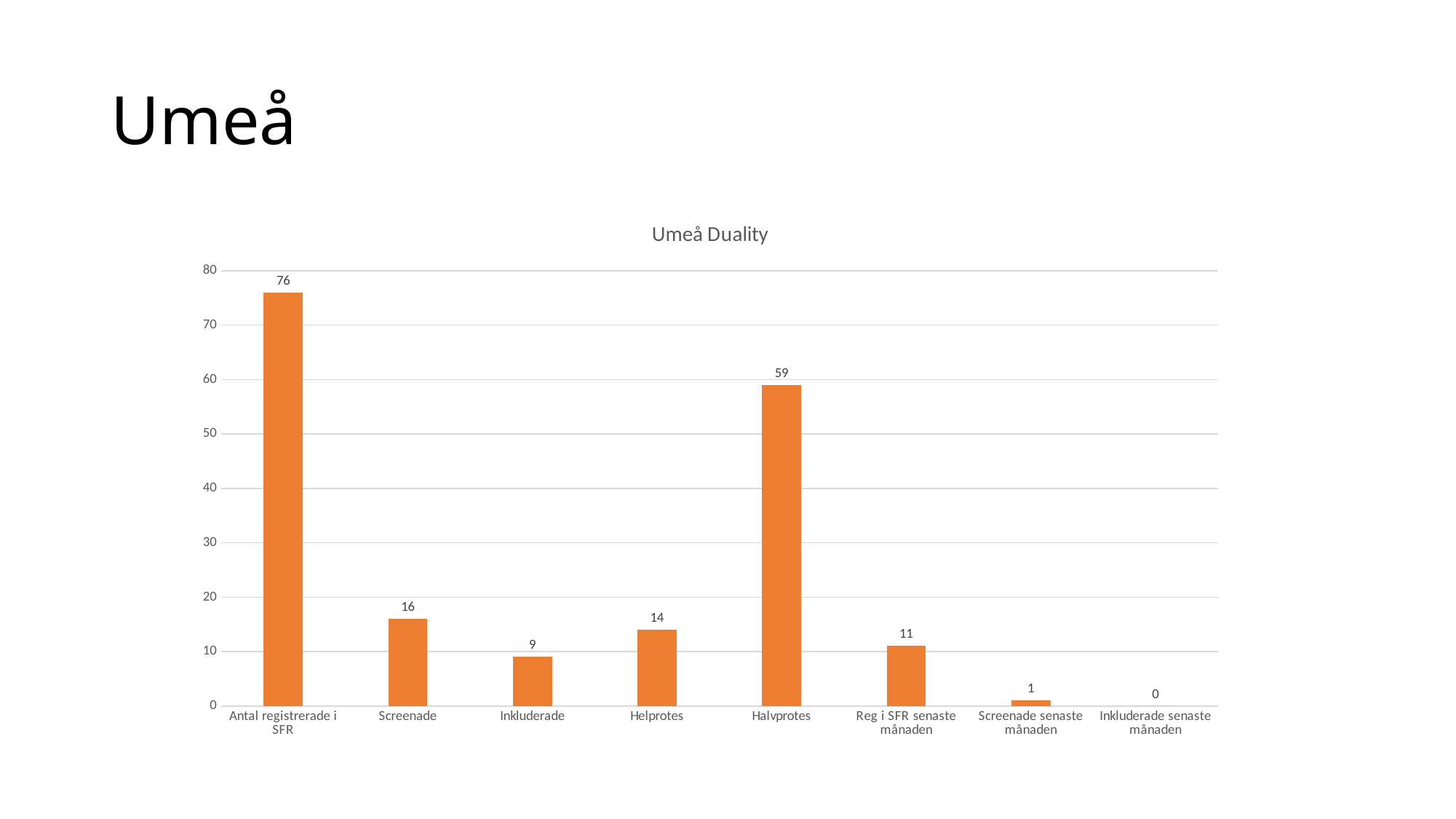
How many categories are shown on the x axis? 8 What is the title of the chart? Umeå Duality What is the value for Screenade senaste månaden? 1 What is the value for Inkluderade? 9 Which category has the highest value? Antal registrerade i SFR What is the difference between Antal registrerade i SFR and Halvprotes? 17 Which category has the lowest value? Inkluderade senaste månaden What kind of chart is this? Bar chart What is the difference between Screenade and Helprotes? 2 What is the value for Antal registrerade i SFR? 76 Which is larger, Screenade or Reg i SFR senaste månaden? Screenade What is the value for Halvprotes? 59